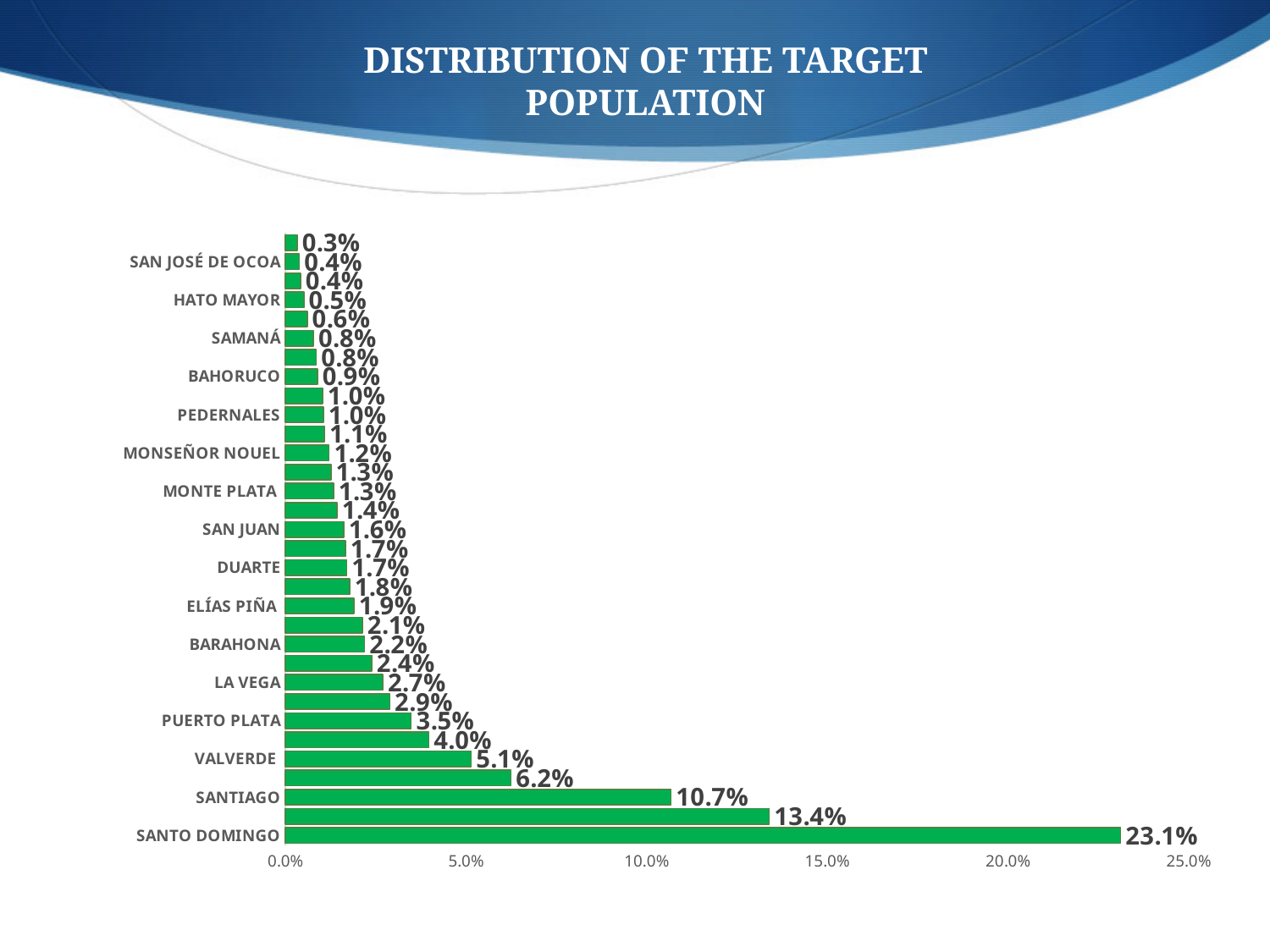
What is the value for SANTIAGO? 10.7% Is the value for SANTIAGO greater or less than 10.0%? greater What kind of chart is shown on the slide? bar chart Which is larger, the value for VALVERDE or the value for PUERTO PLATA? VALVERDE Which category has the highest value? SANTO DOMINGO What is the value for PUERTO PLATA? 3.5% What is the smallest value shown on the chart? 0.3% What is the value for LA VEGA? 2.7% What is the title of the slide? DISTRIBUTION OF THE TARGET POPULATION What is the difference between the values for SANTO DOMINGO and SANTIAGO? 12.4% What is the value for SANTO DOMINGO? 23.1% What is the value for VALVERDE? 5.1%